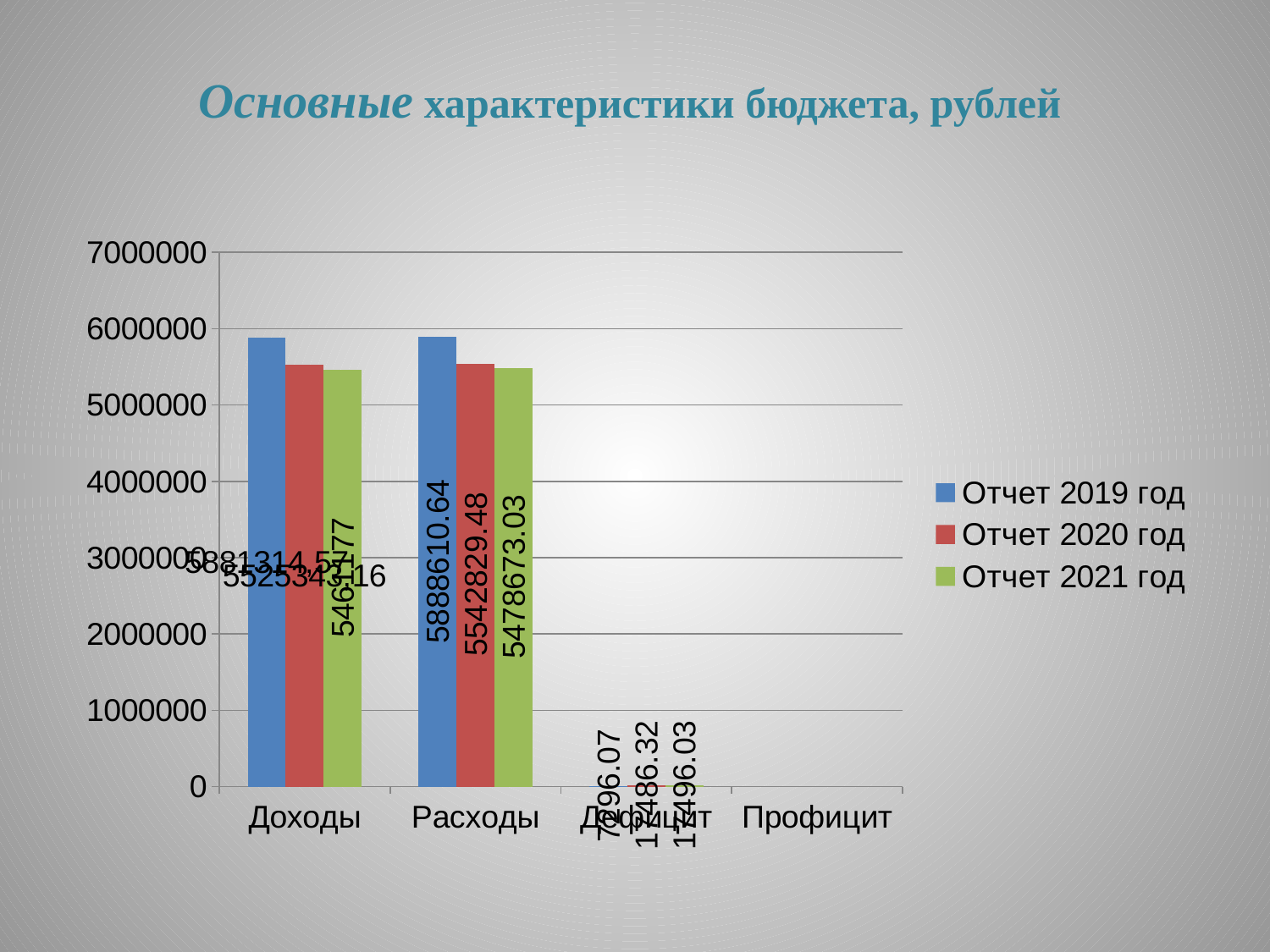
What is the value for Расходы in the series Отчет 2019 год? 5888610.64 Which series has the highest value for Расходы? Отчет 2019 год Is the value for Доходы in the series Отчет 2019 год greater or less than 5000000? greater How many categories are shown on the x axis? 4 What is the value for Расходы in the series Отчет 2020 год? 5542829.48 Which is larger: Доходы for Отчет 2019 год or Доходы for Отчет 2021 год? Отчет 2019 год Which series has the lowest value for Расходы? Отчет 2021 год What is the value for Расходы in the series Отчет 2021 год? 5478673.03 How many series does the legend list? 3 What is the difference between the Расходы values for Отчет 2019 год and Отчет 2020 год? 345781.16 What kind of chart is shown on the slide? bar chart What is the title of the chart? Основные характеристики бюджета, рублей